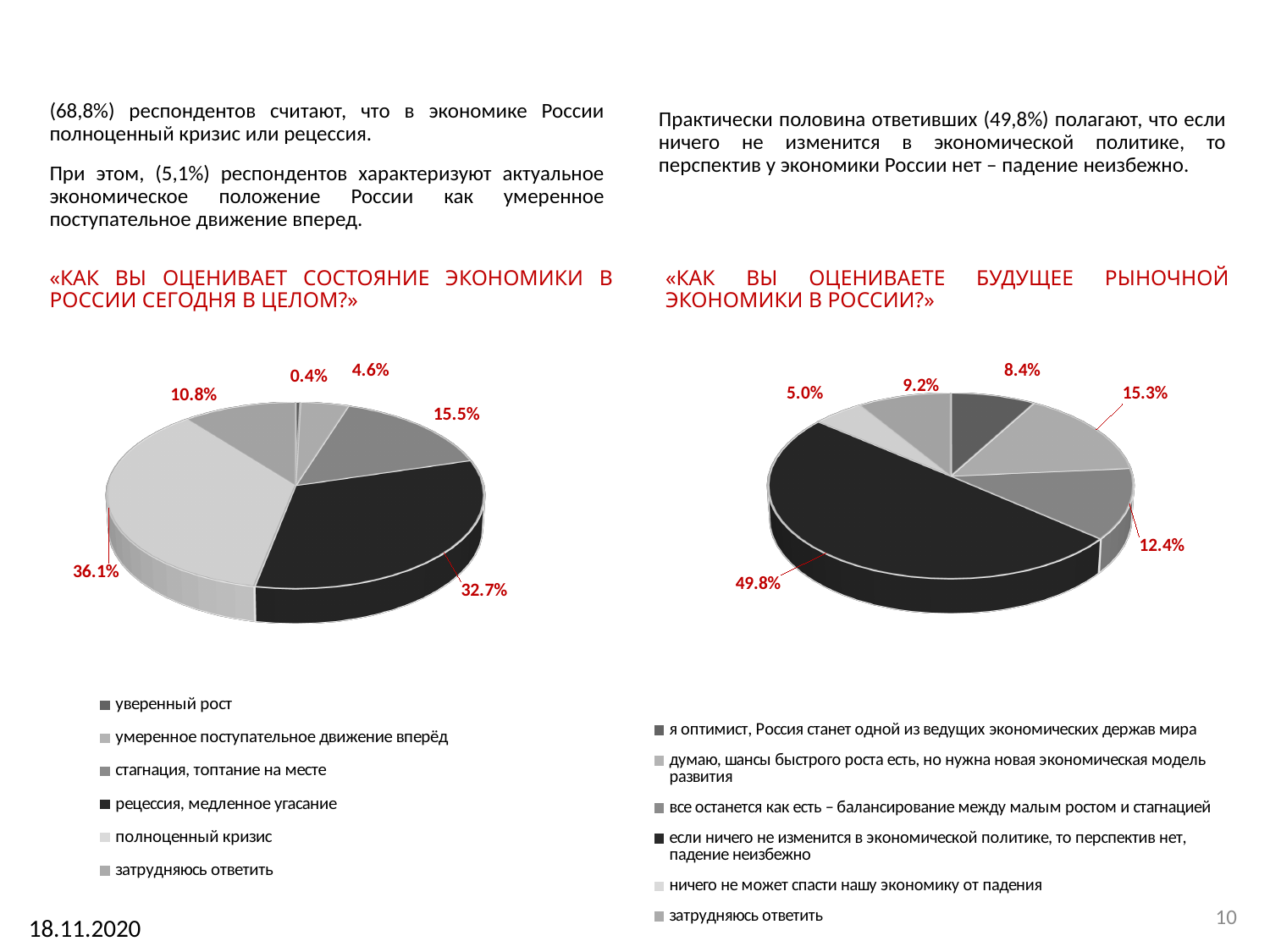
In the left pie chart (state of the economy today), what is the difference between the 36.1% slice and the 32.7% slice? 3.4% In the right pie chart (future of the market economy), what is the smallest slice's value? 5.0% What kind of chart is used on the left, titled «КАК ВЫ ОЦЕНИВАЕТ СОСТОЯНИЕ ЭКОНОМИКИ В РОССИИ СЕГОДНЯ В ЦЕЛОМ?»? Pie chart In the left pie chart (state of the economy today), what share is shown for «полноценный кризис»? 36.1% In the left pie chart (state of the economy today), what is the largest slice's value? 36.1% In the right pie chart (future of the market economy), which is larger: the 15.3% slice or the 12.4% slice? 15.3% What is the title of the right pie chart? «КАК ВЫ ОЦЕНИВАЕТЕ БУДУЩЕЕ РЫНОЧНОЙ ЭКОНОМИКИ В РОССИИ?» In the left pie chart (state of the economy today), how many slices does the legend list? 6 In the left pie chart (state of the economy today), what is the smallest slice's value? 0.4% In the right pie chart (future of the market economy), how many categories does the legend list? 6 In the left pie chart (state of the economy today), what share is shown for «рецессия, медленное угасание»? 32.7% In the right pie chart (future of the market economy), what share is shown for «если ничего не изменится в экономической политике, то перспектив нет, падение неизбежно»? 49.8%